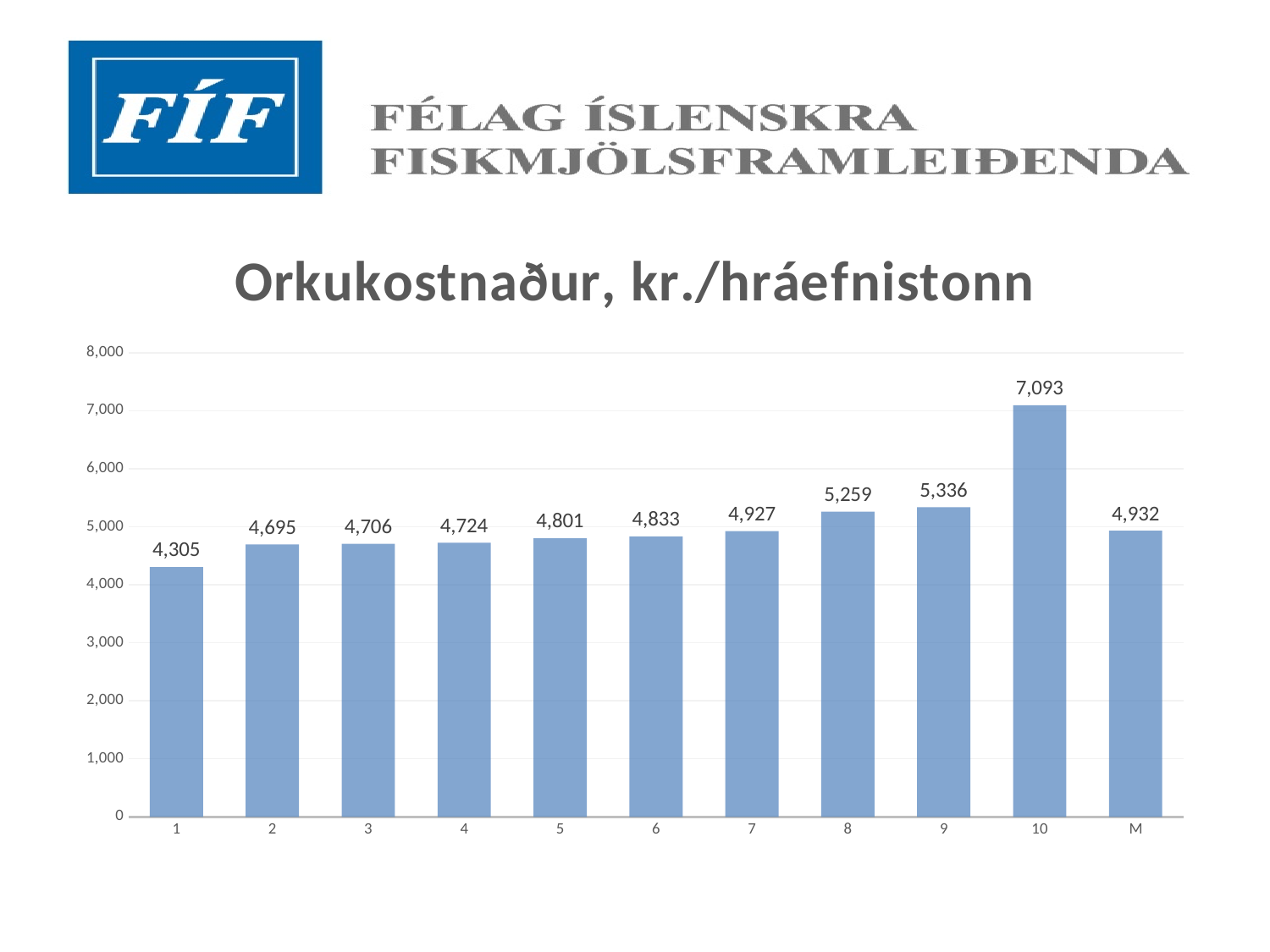
Which category has the lowest value? 1 Which category has the highest value? 10 What is the value for category 7? 4,927 What kind of chart is shown on the slide? bar chart What is the value for category 1? 4,305 How many bars are shown in the chart? 11 What is the value for category 10? 7,093 What is the difference between the values for category 10 and category 9? 1,757 What is the title of the chart? Orkukostnaður, kr./hráefnistonn Which is larger, the value for category 8 or the value for category M? category 8 What is the value for category M? 4,932 Is the value for category 9 greater or less than 5,000? greater